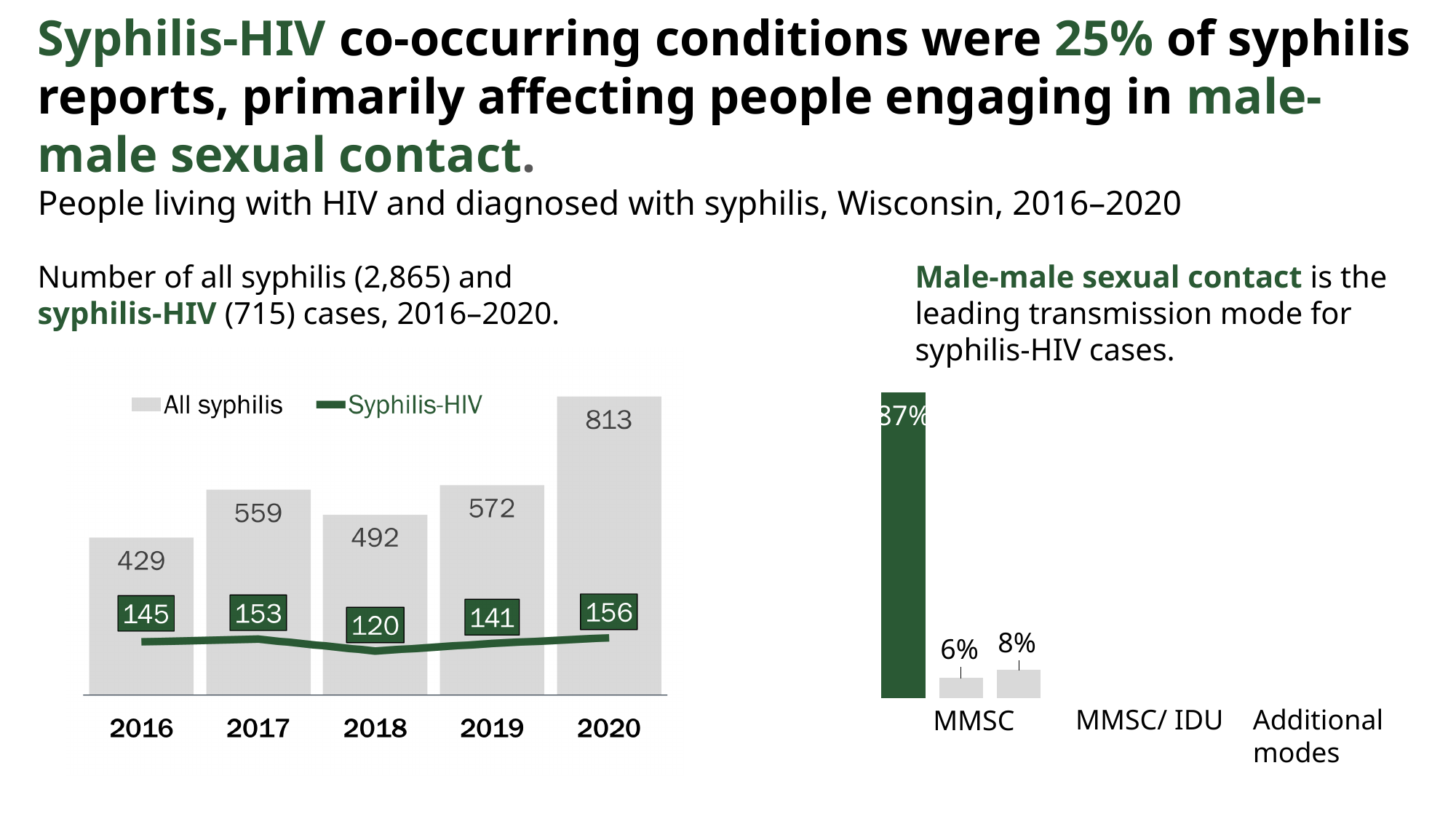
In the left chart, what is the difference between the All syphilis values for 2020 and 2019? 241 In the left chart, which year has the lowest Syphilis-HIV value? 2018 In the left chart, which year has the highest number of all syphilis cases? 2020 In the left chart, how many series does the legend list? 2 What kind of chart is the right chart? Bar chart In the left chart, which is larger: the All syphilis value for 2017 or for 2018? 2017 In the left chart, how many years are shown on the x axis? 5 In the left chart, how many all-syphilis cases were reported in 2020? 813 In the left chart, what is the Syphilis-HIV value for 2020? 156 In the left chart, what is the All syphilis value for 2016? 429 In the right chart, how many bars are plotted? 3 In the left chart, what is the Syphilis-HIV value for 2018? 120